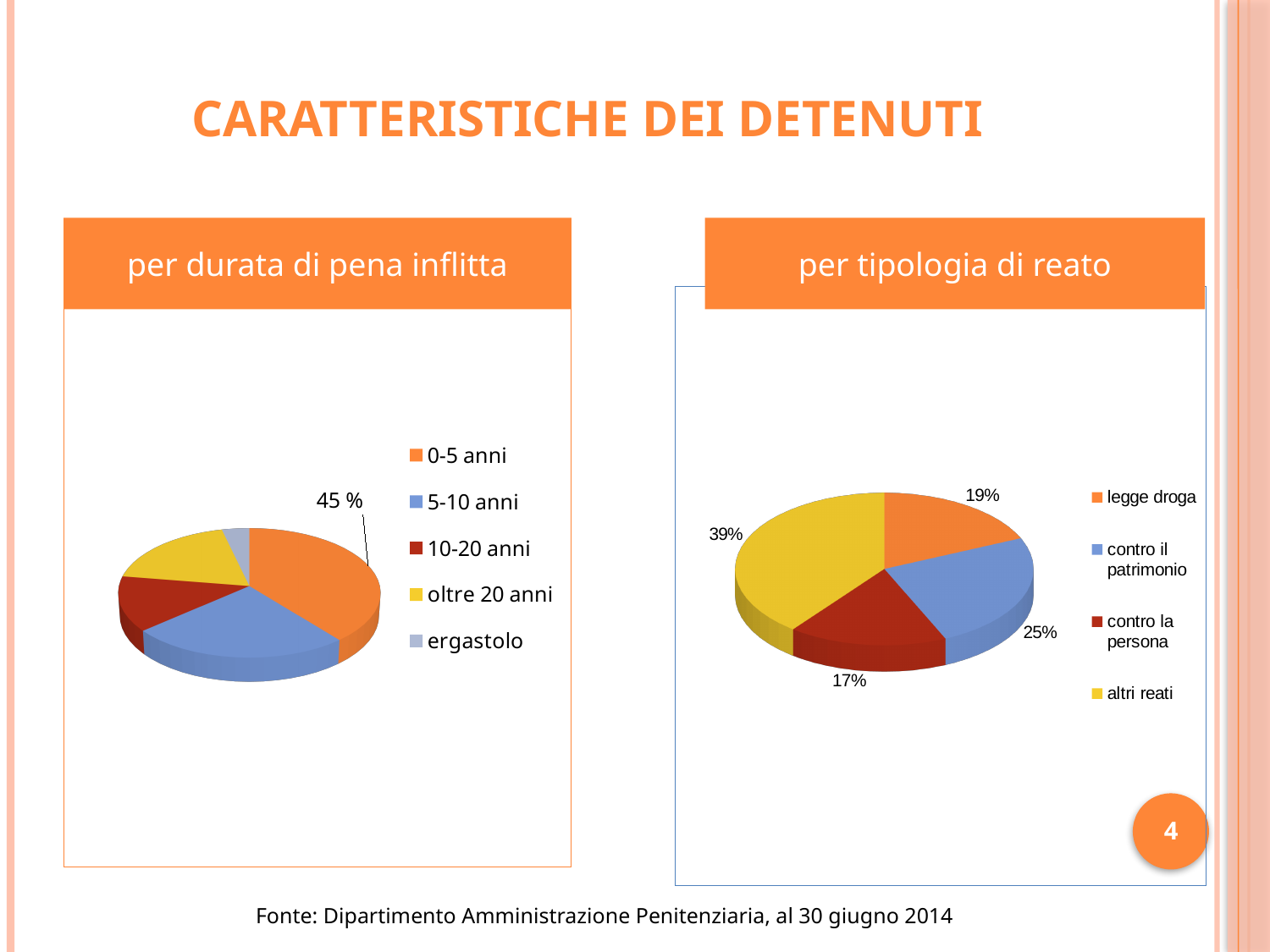
In the "per durata di pena inflitta" chart, which legend entry is shown in yellow? oltre 20 anni In the "per durata di pena inflitta" chart, what share is labelled for "0-5 anni"? 45 % In the "per tipologia di reato" chart, what share is labelled for "contro la persona"? 17% How many categories does the legend of the "per durata di pena inflitta" chart list? 5 In the "per tipologia di reato" chart, which is larger: "legge droga" or "contro il patrimonio"? contro il patrimonio In the "per tipologia di reato" chart, which category has the largest slice? altri reati In the "per tipologia di reato" chart, what is the difference in percentage points between "altri reati" and "contro il patrimonio"? 14 What kind of chart is shown under "per tipologia di reato"? pie chart In the "per tipologia di reato" chart, what share is labelled for "altri reati"? 39% In the "per tipologia di reato" chart, what share is labelled for "legge droga"? 19% In the "per tipologia di reato" chart, what share is labelled for "contro il patrimonio"? 25% In the "per tipologia di reato" chart, which category has the smallest slice? contro la persona